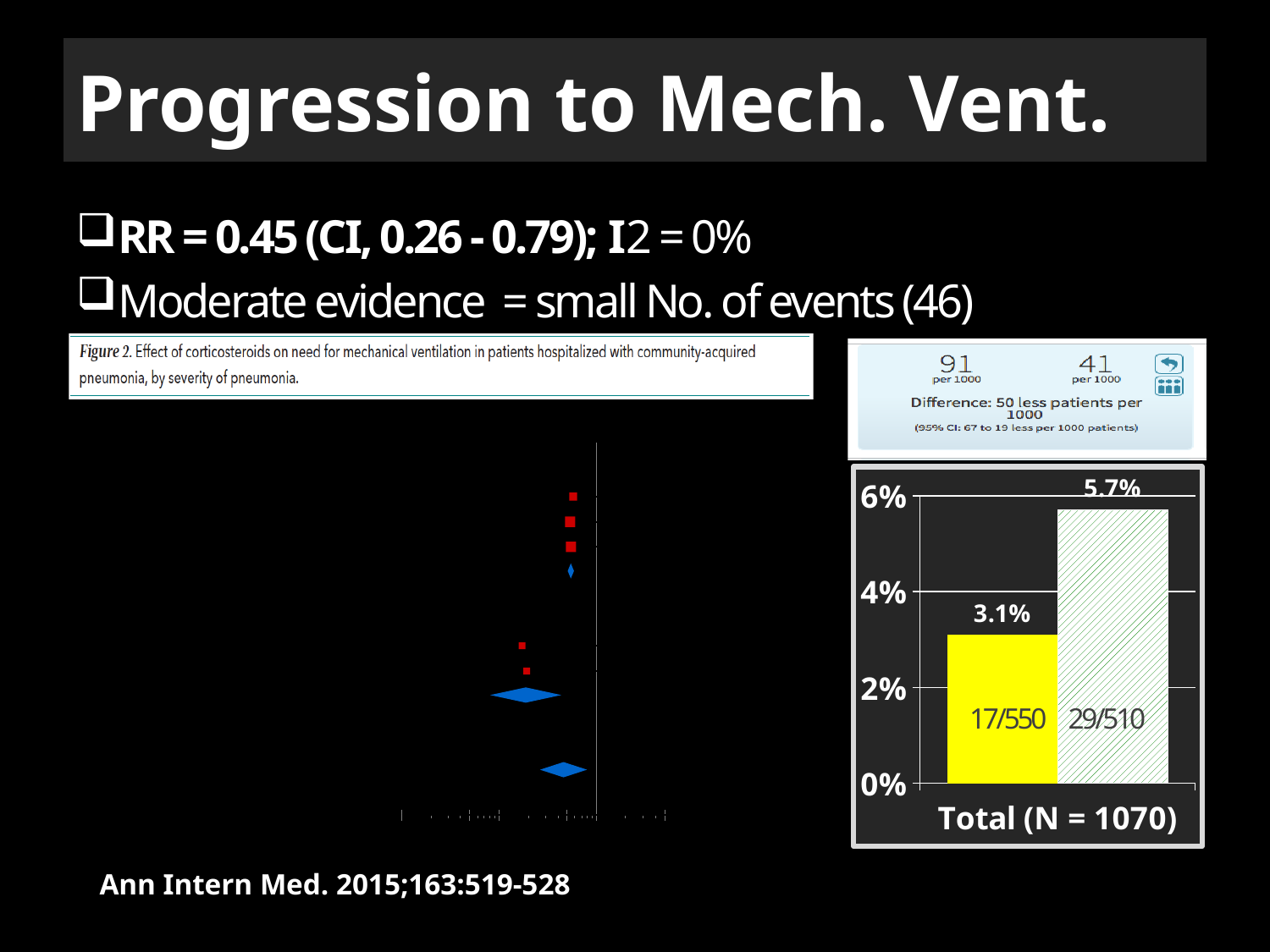
On the bar chart on the right, what value is printed on the hatched bar? 5.7% What kind of chart is shown on the right side of the slide? bar chart On the bar chart on the right, is the value of the yellow bar greater or less than 4%? less On the bar chart on the right, which bar is taller, the yellow bar or the hatched bar? the hatched bar On the bar chart on the right, what is the label printed below the x axis? Total (N = 1070) On the bar chart on the right, what fraction is printed inside the yellow bar? 17/550 On the bar chart on the right, how many bars are plotted? 2 On the bar chart on the right, what value is printed on the yellow bar? 3.1% On the bar chart on the right, what is the highest tick value shown on the y axis? 6% On the bar chart on the right, is the value of the hatched bar greater or less than 4%? greater On the bar chart on the right, what fraction is printed inside the hatched bar? 29/510 On the bar chart on the right, what is the difference between the hatched bar's value and the yellow bar's value? 2.6%